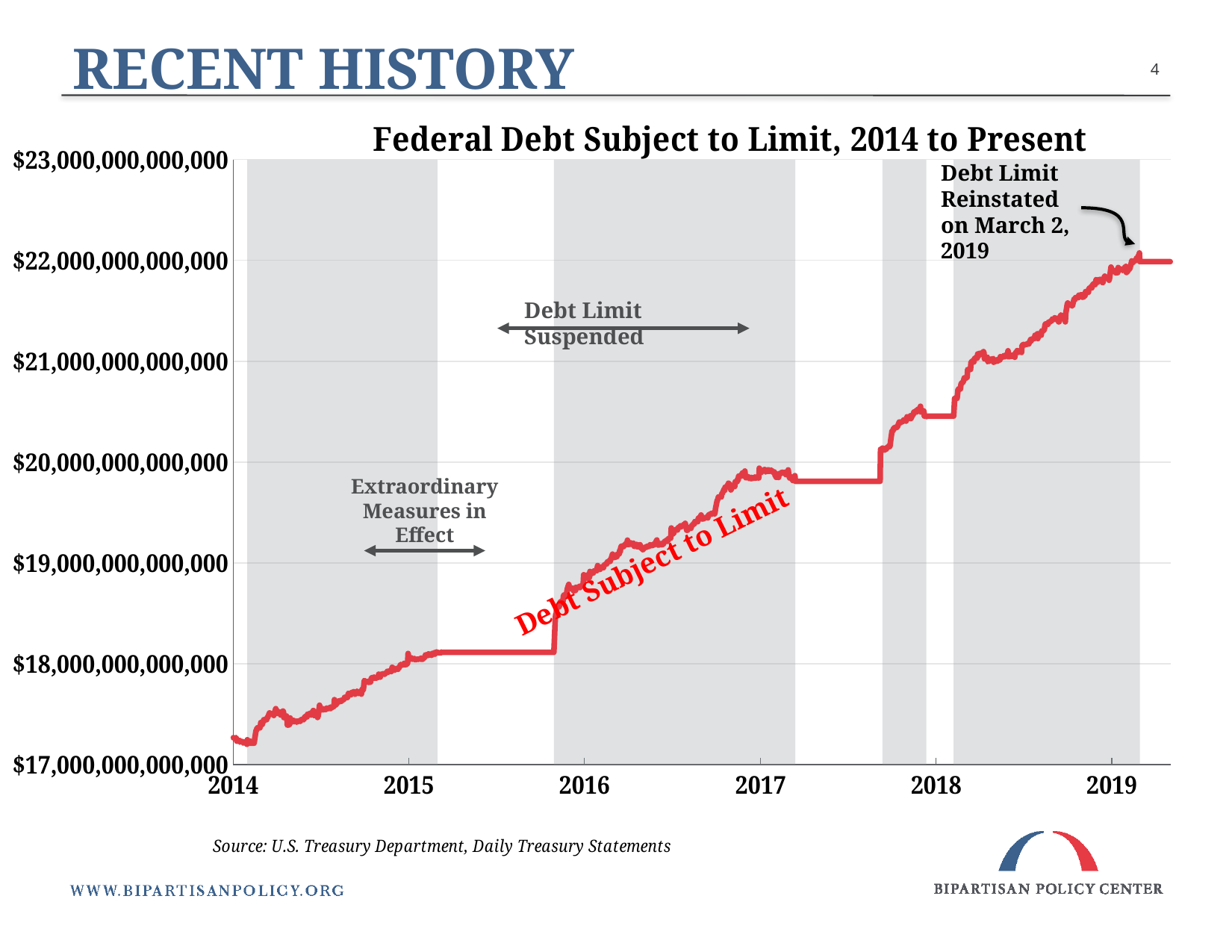
What is the highest value labeled on the y axis? $23,000,000,000,000 Which year on the x axis has the higher debt subject to limit, 2015 or 2018? 2018 How many year labels are shown on the x axis? 6 Is the value of debt subject to limit at the start of 2017 greater or less than $19,000,000,000,000? greater Is the value of debt subject to limit at the start of 2018 greater or less than $20,000,000,000,000? greater Is the value of debt subject to limit at the start of 2014 greater or less than $18,000,000,000,000? less Does the debt subject to limit generally rise or fall from 2014 to 2019? rise What is the title of the chart? Federal Debt Subject to Limit, 2014 to Present What kind of chart is shown on the slide? line chart On what date does the annotation say the debt limit was reinstated? March 2, 2019